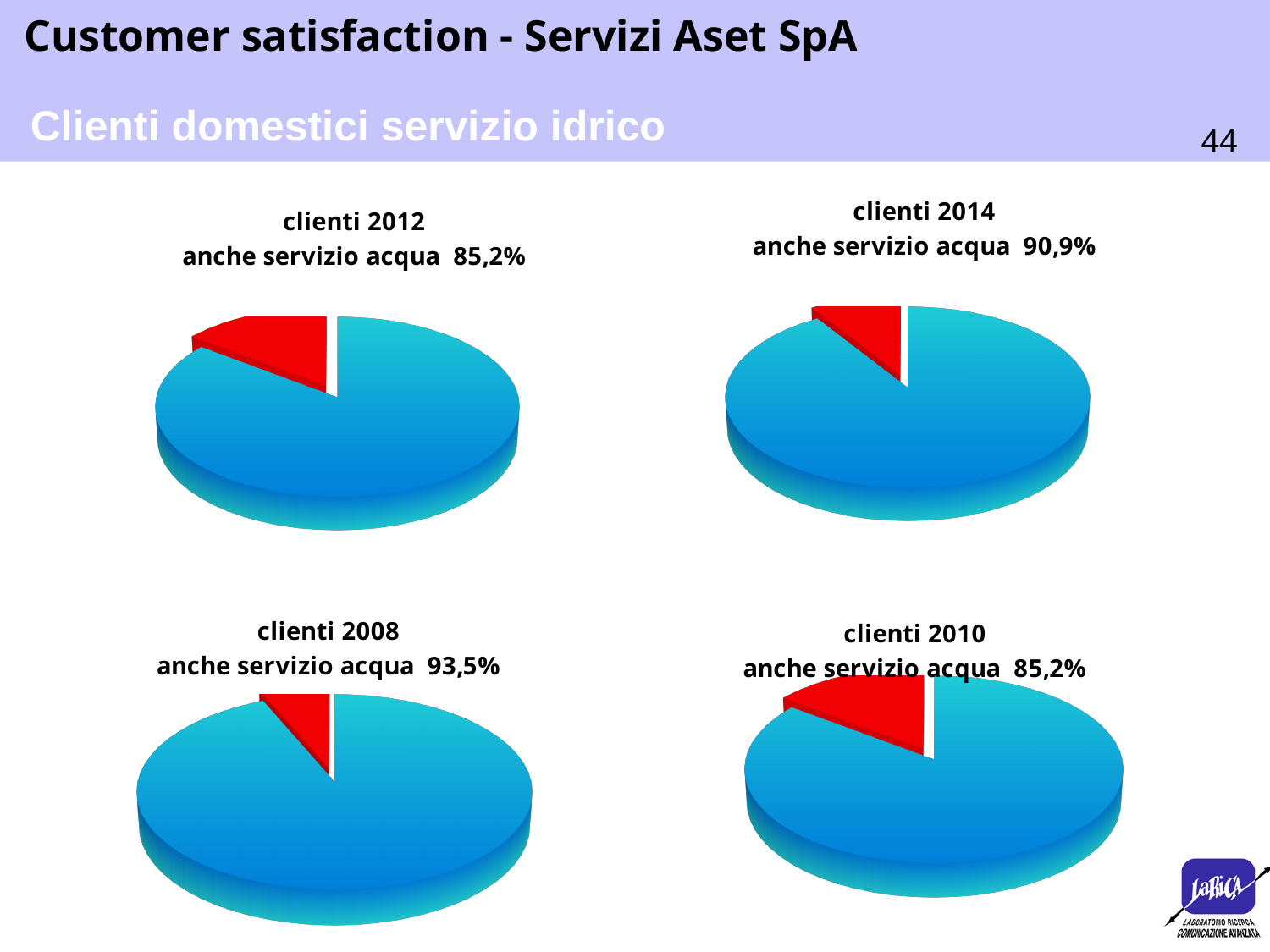
What is the difference in percentage points between the "anche servizio acqua" value in the "clienti 2008" chart and the "clienti 2012" chart? 8,3 How many slices does the "clienti 2014" pie chart have? 2 Which is larger: the "anche servizio acqua" percentage in the "clienti 2014" chart or in the "clienti 2012" chart? clienti 2014 Across the four charts, which year's chart shows the highest "anche servizio acqua" percentage? clienti 2008 In the chart titled "clienti 2010", what percentage is given for "anche servizio acqua"? 85,2% How many pie charts are shown on the slide? 4 What is the difference in percentage points between the "anche servizio acqua" value in the "clienti 2014" chart and the "clienti 2010" chart? 5,7 In the chart titled "clienti 2008", what percentage is given for "anche servizio acqua"? 93,5% In the chart titled "clienti 2014", what percentage is given for "anche servizio acqua"? 90,9% What type of chart is the "clienti 2008" chart? Pie chart In the "clienti 2012" chart, what colour is the smaller slice? Red In the chart titled "clienti 2012", what percentage is given for "anche servizio acqua"? 85,2%